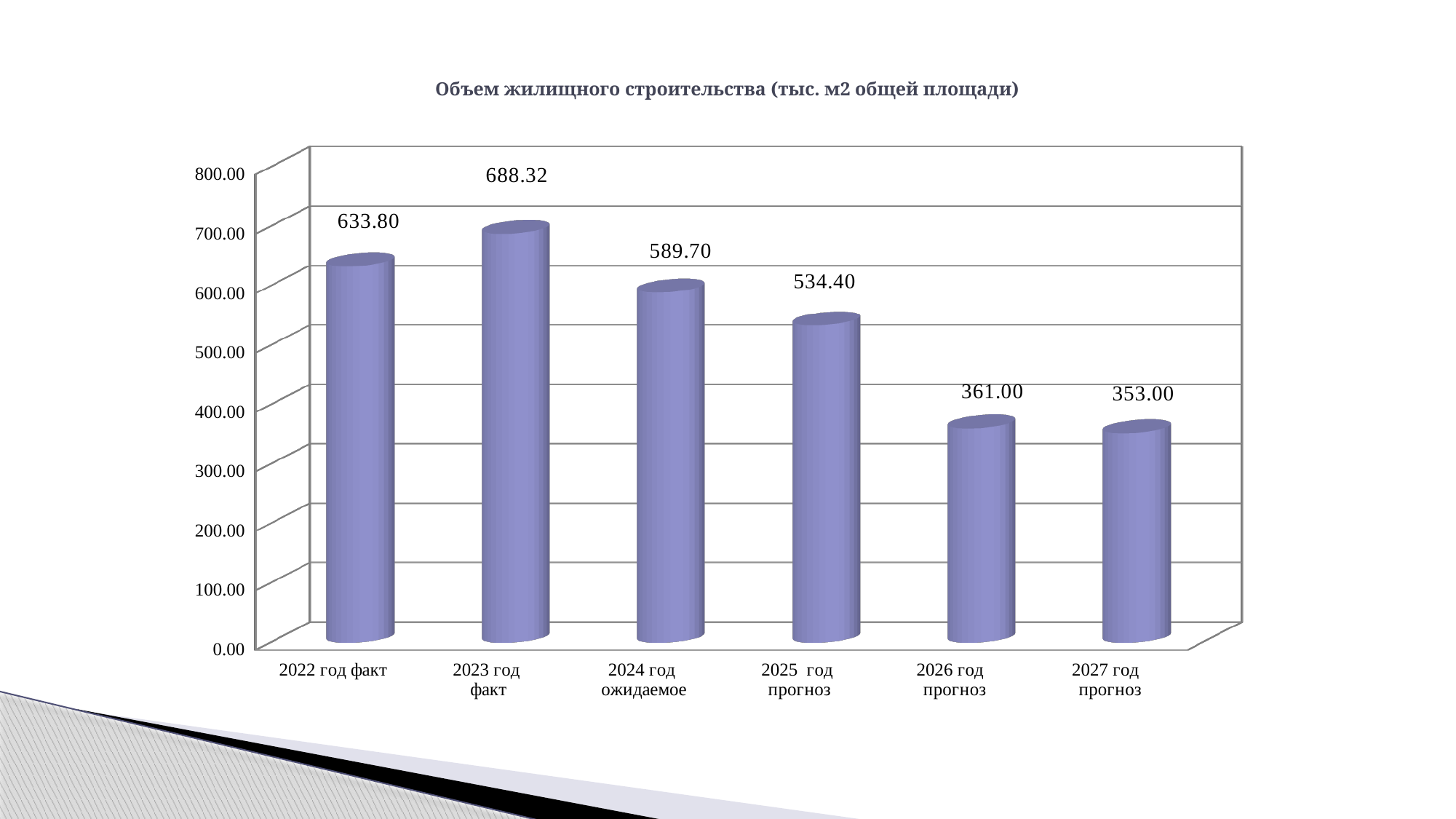
Which category has the lowest value? 2027 год прогноз What is the value for 2026 год прогноз? 361.00 How many categories are shown on the x axis? 6 What is the value for 2024 год ожидаемое? 589.70 From 2023 год факт to 2027 год прогноз, do the values rise or fall? fall Which is larger, the value for 2024 год ожидаемое or the value for 2025 год прогноз? 2024 год ожидаемое What is the difference between the values for 2026 год прогноз and 2027 год прогноз? 8.00 What kind of chart is shown on the slide? bar chart What is the difference between the values for 2023 год факт and 2022 год факт? 54.52 Which category has the highest value? 2023 год факт Is the value for 2025 год прогноз greater or less than 500.00? greater What is the value for 2022 год факт? 633.80